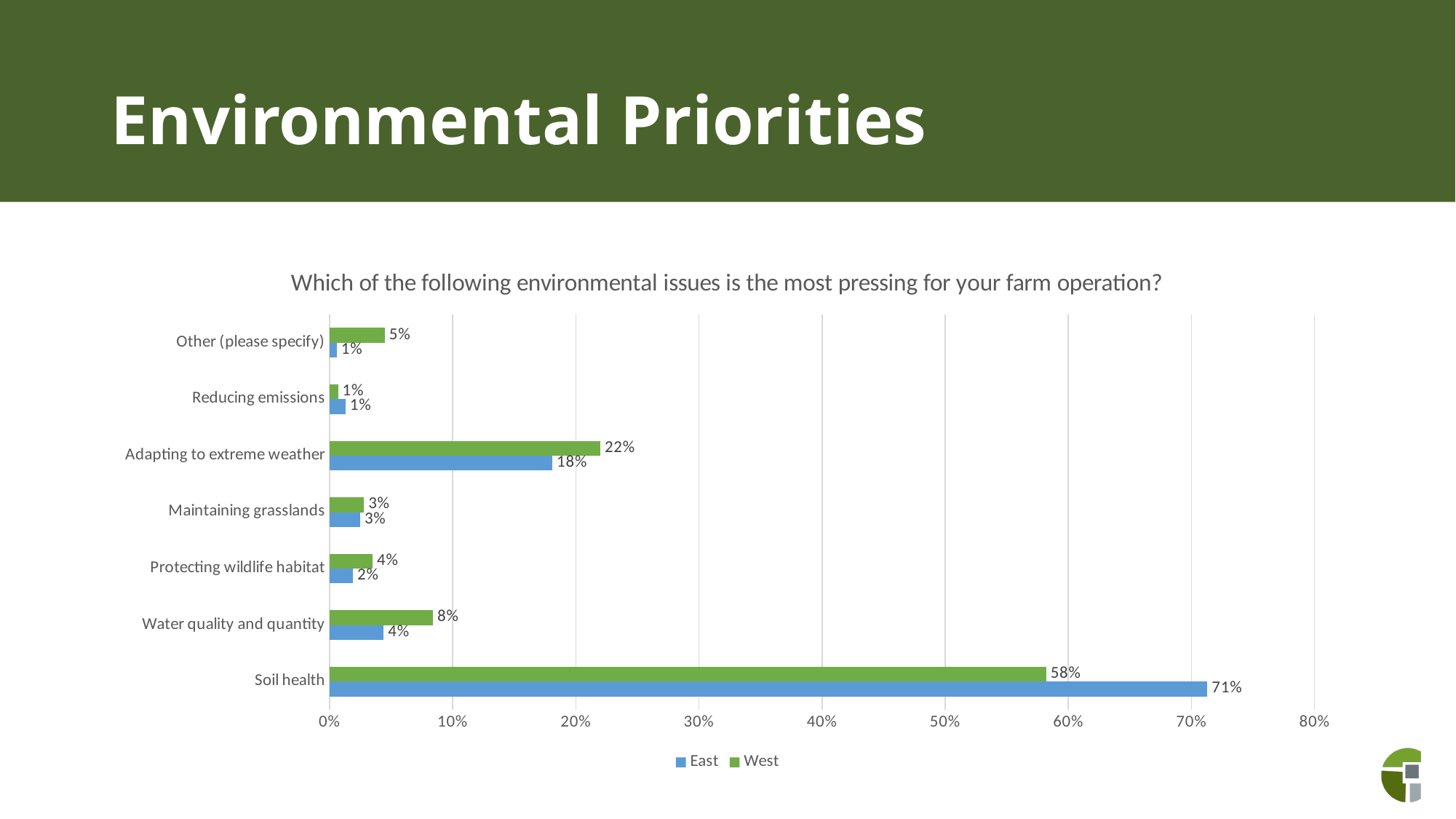
What is the East value for Soil health? 71% What is the West value for Adapting to extreme weather? 22% How many categories are shown on the chart? 7 What is the difference between the East and West values for Soil health? 13% What is the West value for Water quality and quantity? 8% What is the East value for Protecting wildlife habitat? 2% Which is larger for Other (please specify): the East value or the West value? West Is the East value for Soil health greater or less than 60%? greater How many series does the legend list? 2 Which category has the highest West value? Soil health What is the difference between the West and East values for Adapting to extreme weather? 4% What kind of chart is shown on the slide? Bar chart